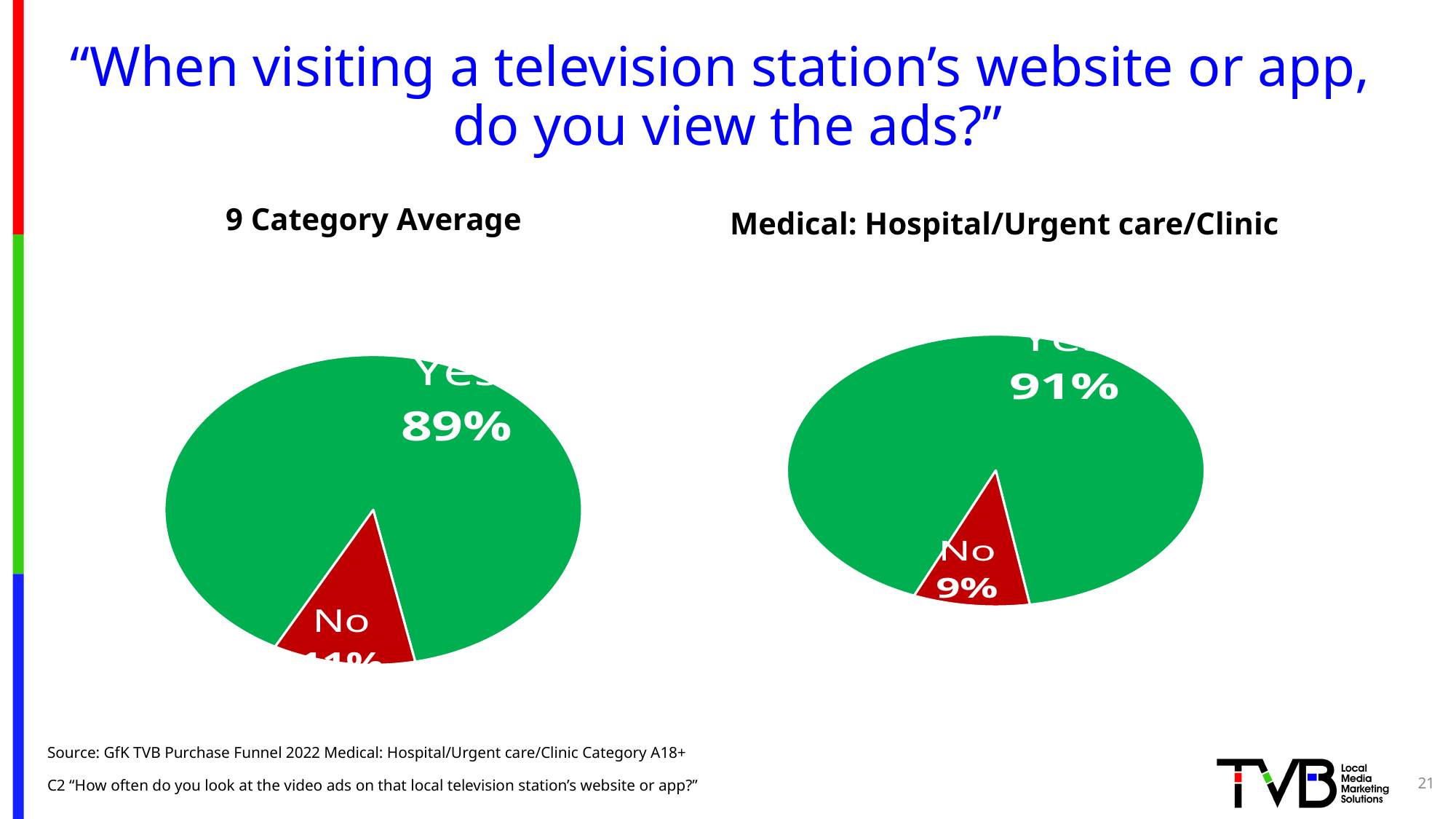
Which chart shows a higher Yes percentage, 9 Category Average or Medical: Hospital/Urgent care/Clinic? Medical: Hospital/Urgent care/Clinic What type of chart is used on this slide? Pie chart What colour is the No slice in the pie charts? Red In the 9 Category Average chart, what percentage answered Yes? 89% How many slices does each pie chart on the slide have? 2 In the Medical: Hospital/Urgent care/Clinic chart, what percentage answered No? 9% In the Medical: Hospital/Urgent care/Clinic chart, what share of the pie does the Yes slice represent? 91% What is the difference between the Yes percentage in the Medical: Hospital/Urgent care/Clinic chart and the Yes percentage in the 9 Category Average chart? 2 percentage points In the 9 Category Average chart, which response has the smallest slice? No In the Medical: Hospital/Urgent care/Clinic chart, what percentage answered Yes? 91% In the Medical: Hospital/Urgent care/Clinic chart, which response has the largest slice? Yes How many pie charts are shown on the slide? 2